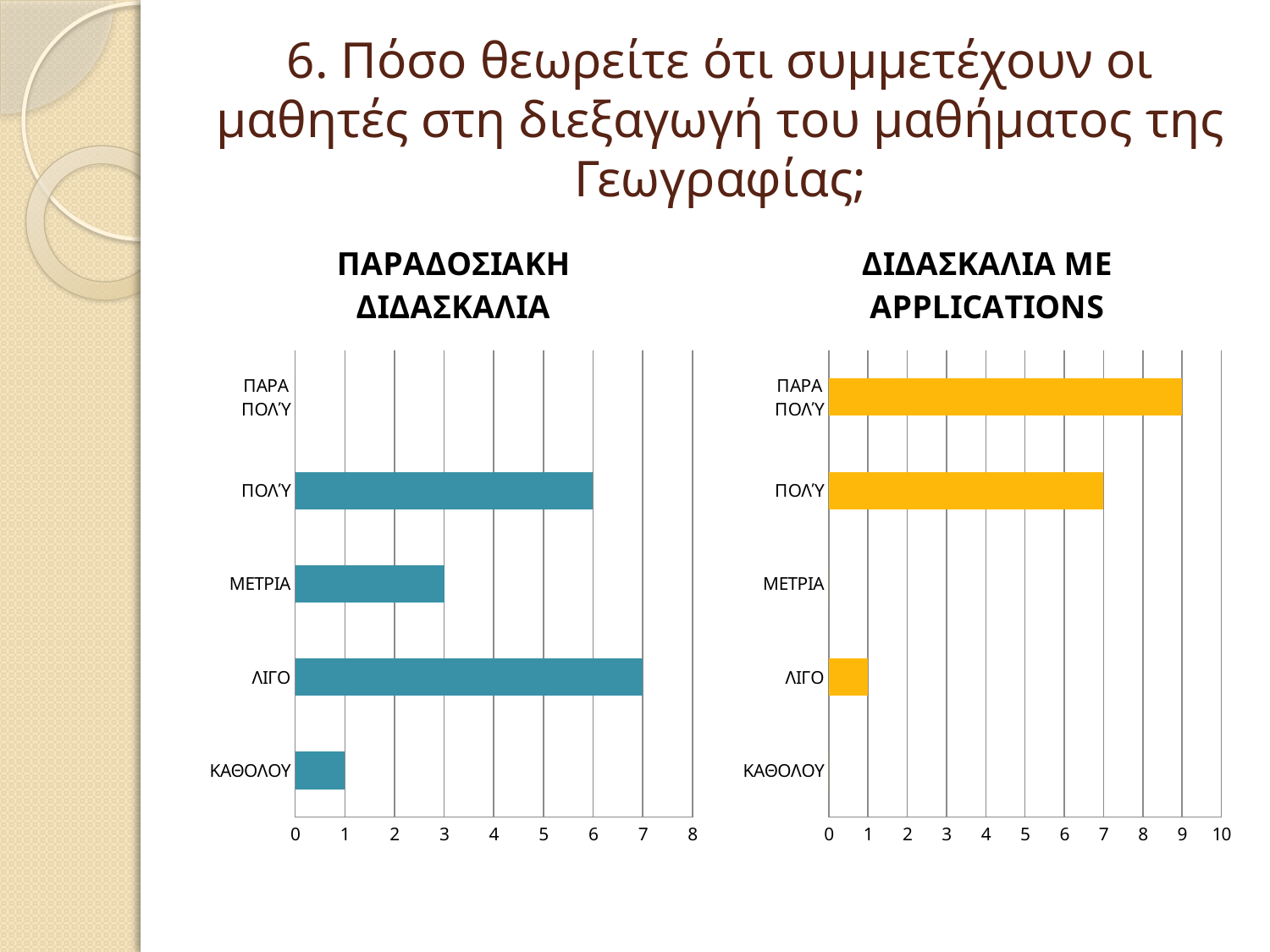
In the ΠΑΡΑΔΟΣΙΑΚΗ ΔΙΔΑΣΚΑΛΙΑ chart, what is the difference between ΛΙΓΟ and ΜΕΤΡΙΑ? 4 In the ΔΙΔΑΣΚΑΛΙΑ ΜΕ APPLICATIONS chart, what is the difference between ΠΑΡΑ ΠΟΛΎ and ΛΙΓΟ? 8 In the ΔΙΔΑΣΚΑΛΙΑ ΜΕ APPLICATIONS chart, what is the value for ΠΑΡΑ ΠΟΛΎ? 9 In the ΔΙΔΑΣΚΑΛΙΑ ΜΕ APPLICATIONS chart, what is the value for ΠΟΛΎ? 7 Which is larger: ΠΟΛΎ in the ΠΑΡΑΔΟΣΙΑΚΗ ΔΙΔΑΣΚΑΛΙΑ chart or ΠΟΛΎ in the ΔΙΔΑΣΚΑΛΙΑ ΜΕ APPLICATIONS chart? ΔΙΔΑΣΚΑΛΙΑ ΜΕ APPLICATIONS In the ΠΑΡΑΔΟΣΙΑΚΗ ΔΙΔΑΣΚΑΛΙΑ chart, what is the value for ΛΙΓΟ? 7 In the ΠΑΡΑΔΟΣΙΑΚΗ ΔΙΔΑΣΚΑΛΙΑ chart, which category has the highest value? ΛΙΓΟ In the ΠΑΡΑΔΟΣΙΑΚΗ ΔΙΔΑΣΚΑΛΙΑ chart, what is the value for ΠΟΛΎ? 6 In the ΔΙΔΑΣΚΑΛΙΑ ΜΕ APPLICATIONS chart, which category has the highest value? ΠΑΡΑ ΠΟΛΎ In the ΠΑΡΑΔΟΣΙΑΚΗ ΔΙΔΑΣΚΑΛΙΑ chart, what is the value for ΚΑΘΟΛΟΥ? 1 What type of chart is the ΔΙΔΑΣΚΑΛΙΑ ΜΕ APPLICATIONS chart? Bar chart How many categories are shown in the ΠΑΡΑΔΟΣΙΑΚΗ ΔΙΔΑΣΚΑΛΙΑ chart? 5